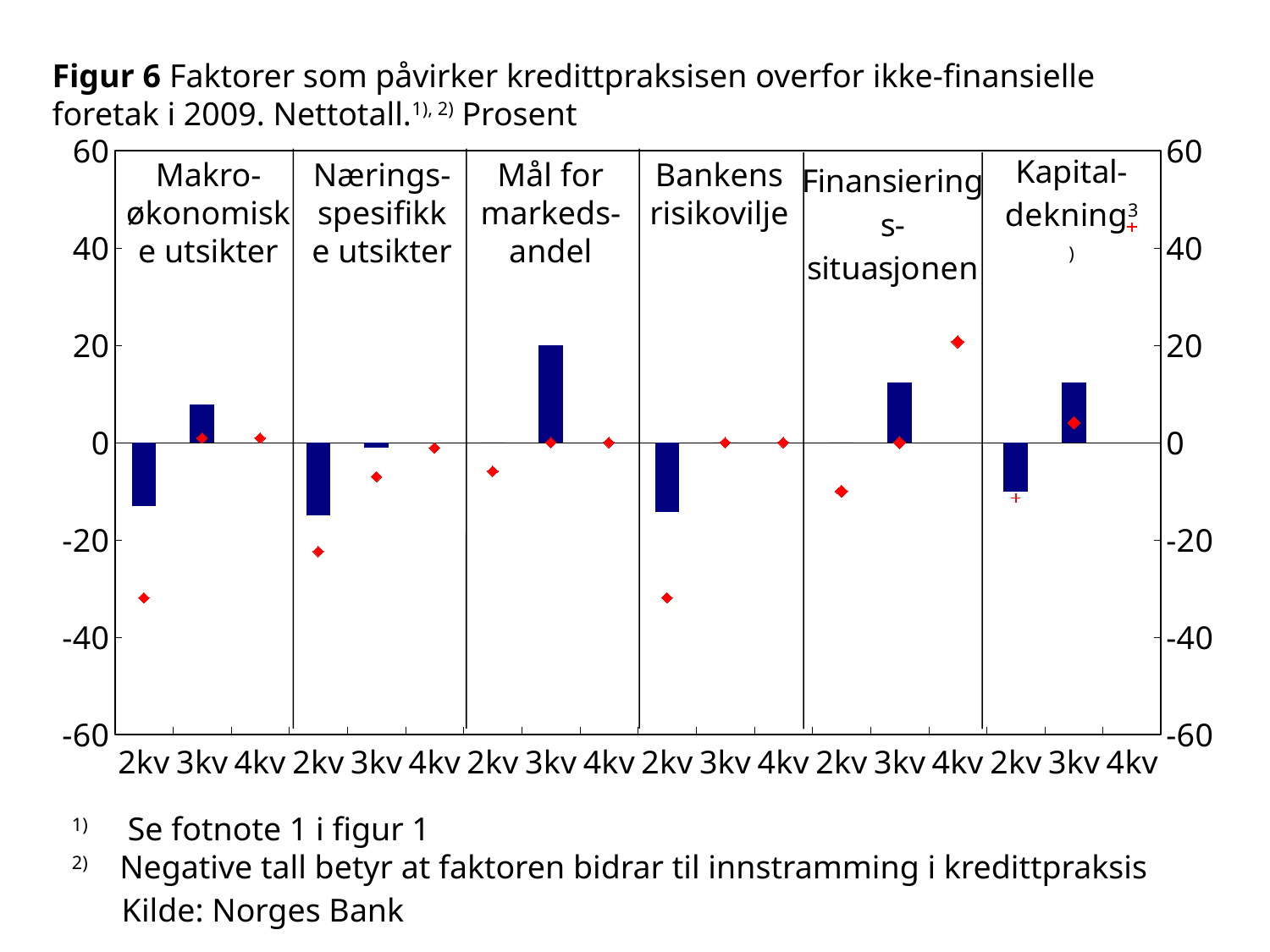
Under 'Makroøkonomiske utsikter', which bar is larger, 2kv or 3kv? 3kv Which quarter has the highest bar under 'Mål for markedsandel'? 3kv What source is given for the chart? Norges Bank Which factor has the tallest positive bar in the chart? Mål for markedsandel Is the red marker for 4kv under 'Finansieringssituasjonen' greater or less than 0? greater Is the red marker for 2kv under 'Makroøkonomiske utsikter' greater or less than -20? less What kind of chart is shown on the slide? combination bar and line chart (bars with red diamond markers) How many factors (panels) are shown along the x axis of the chart? 6 Under 'Næringsspesifikke utsikter', do the bars rise or fall from 2kv to 3kv? rise Is the bar for 3kv under 'Mål for markedsandel' greater or less than 0? greater